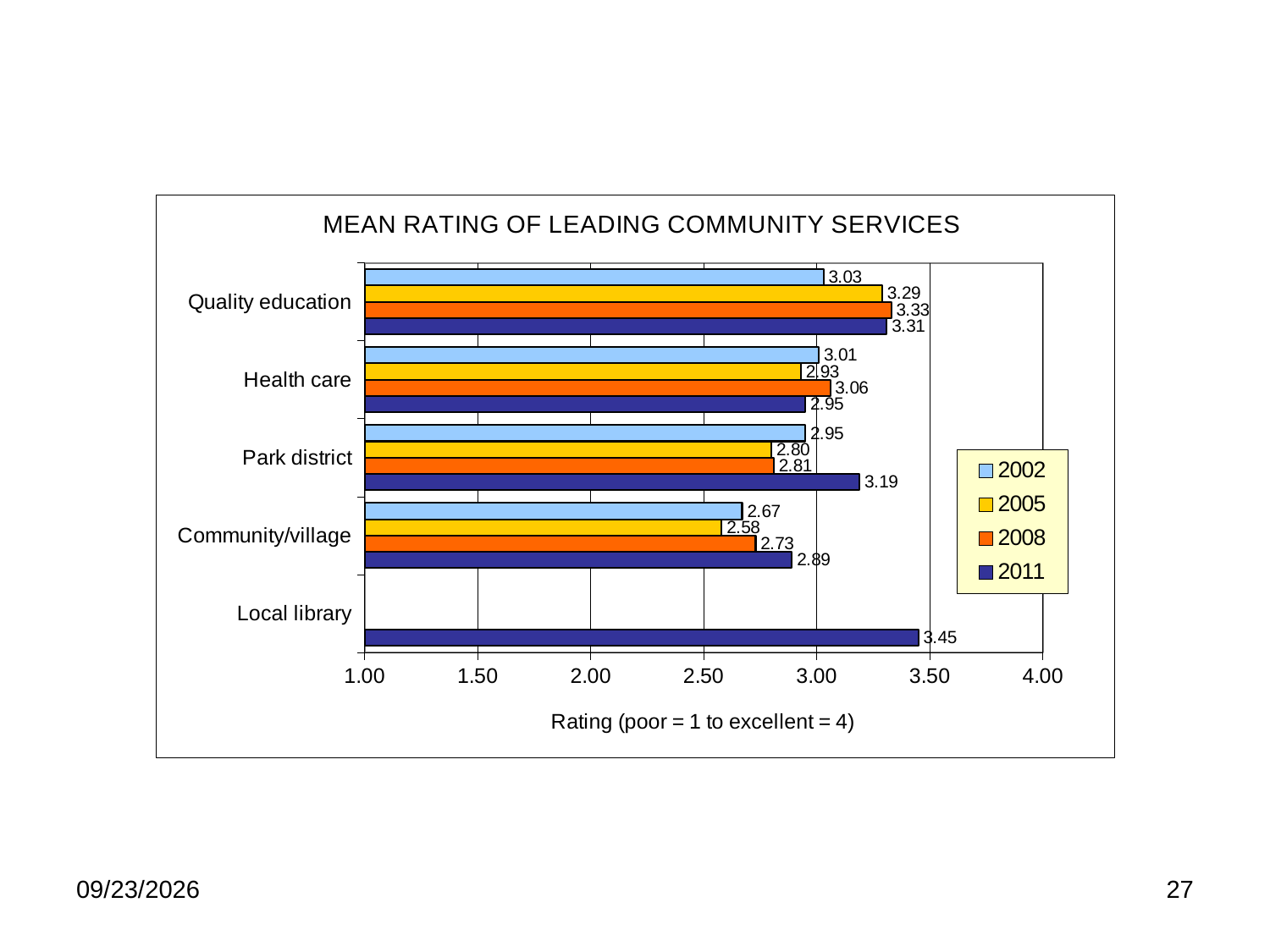
What is the title of the chart? MEAN RATING OF LEADING COMMUNITY SERVICES Which is larger, the 2002 rating for Health care or the 2002 rating for Park district? 2002 rating for Health care What is the difference between the 2011 and 2008 ratings for Park district? 0.38 What is the 2008 rating for Quality education? 3.33 What is the 2011 rating for Local library? 3.45 How many categories are shown on the y axis? 5 What is the 2005 rating for Community/village? 2.58 How many series does the legend list? 4 What kind of chart is shown? bar chart Which category has the lowest 2002 rating? Community/village Which category has the highest 2011 rating? Local library Is the 2011 rating for Community/village greater or less than 3.00? less